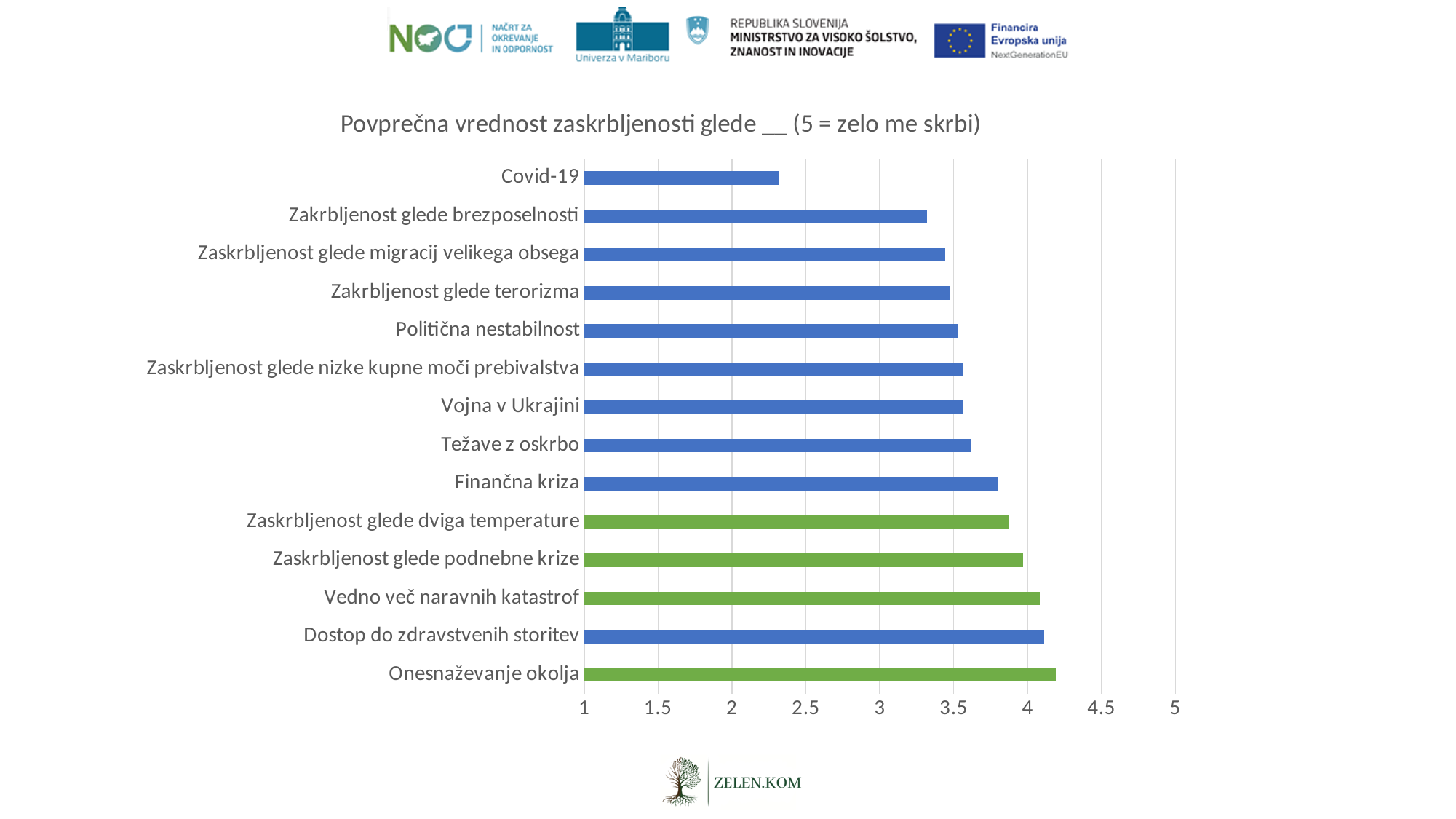
Is the value for Zaskrbljenost glede dviga temperature greater or less than 3.5? greater Is the value for Onesnaževanje okolja greater or less than 4? greater Is the value for Finančna kriza greater or less than 4? less What kind of chart is shown on the slide? bar chart Which category has the lowest value? Covid-19 How many bars in the chart are coloured green? 4 How many categories are plotted in the chart? 14 What is the title of the chart? Povprečna vrednost zaskrbljenosti glede __ (5 = zelo me skrbi) Which category has the highest value? Onesnaževanje okolja Which is larger, the value for Covid-19 or the value for Finančna kriza? Finančna kriza